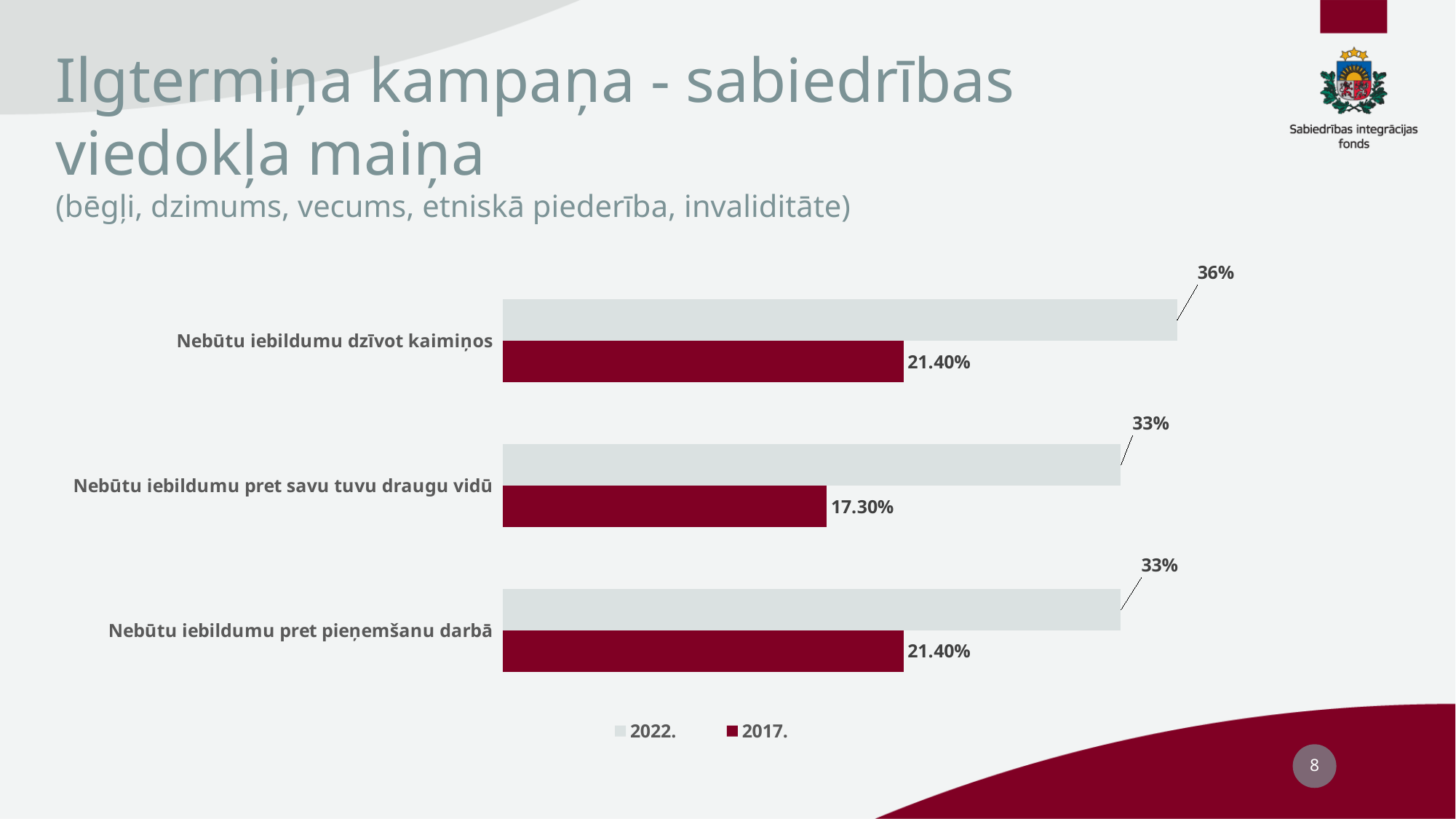
What is the 2017. value for "Nebūtu iebildumu pret savu tuvu draugu vidū"? 17.30% Which category has the highest 2022. value? Nebūtu iebildumu dzīvot kaimiņos How many categories are shown in the chart? 3 What is the 2022. value for "Nebūtu iebildumu dzīvot kaimiņos"? 36% Which category has the lowest 2017. value? Nebūtu iebildumu pret savu tuvu draugu vidū What is the 2017. value for "Nebūtu iebildumu pret pieņemšanu darbā"? 21.40% For "Nebūtu iebildumu pret pieņemšanu darbā", which is larger: the 2022. value or the 2017. value? 2022. What is the difference between the 2022. and 2017. values for "Nebūtu iebildumu pret savu tuvu draugu vidū"? 15.7 percentage points What is the difference between the 2022. and 2017. values for "Nebūtu iebildumu dzīvot kaimiņos"? 14.6 percentage points What is the 2022. value for "Nebūtu iebildumu pret savu tuvu draugu vidū"? 33% What kind of chart is shown on the slide? Bar chart How many series does the legend list? 2